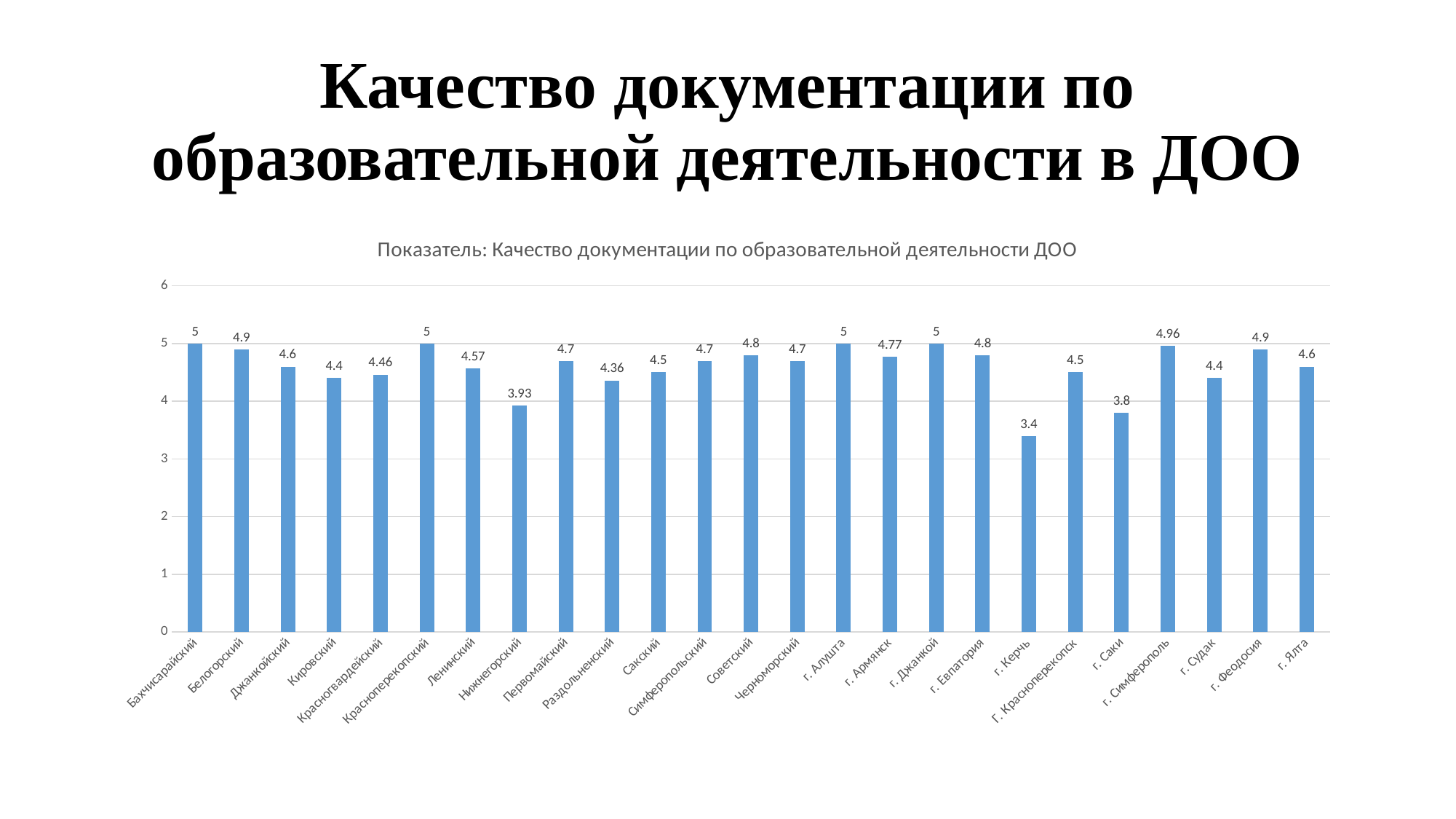
What is the value for г. Симферополь? 4.96 What kind of chart is shown on the slide? bar chart What is the highest value shown on the chart? 5 Is the value for г. Саки greater or less than 4? less What is the difference between the values for Бахчисарайский and Нижнегорский? 1.07 Which is larger, the value for Ленинский or the value for Красногвардейский? Ленинский What is the difference between the values for г. Симферополь and г. Керчь? 1.56 Which category has the lowest value? г. Керчь What is the value for г. Армянск? 4.77 What is the value for Нижнегорский? 3.93 How many categories are shown on the chart? 25 What is the value for Раздольненский? 4.36